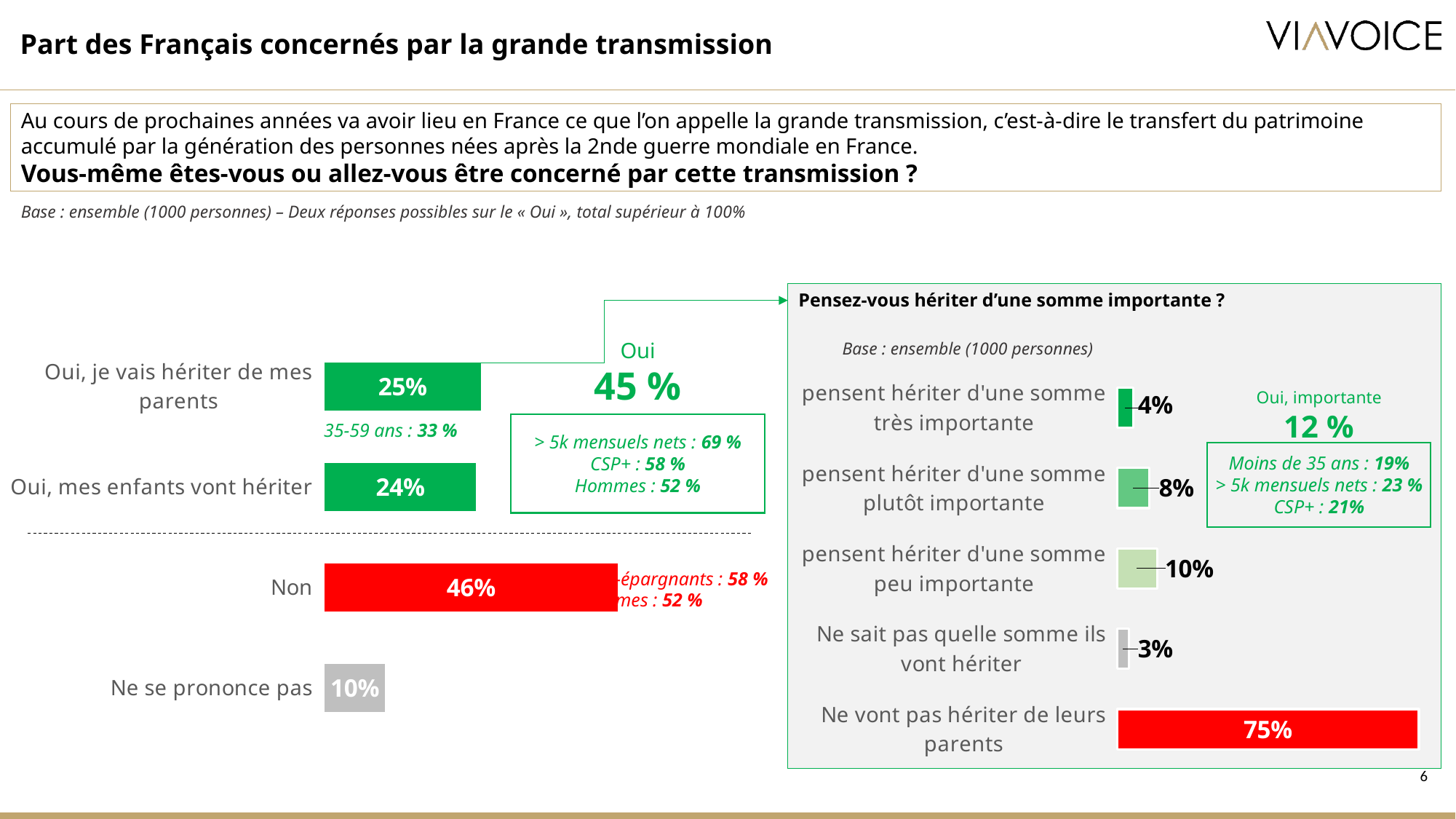
On the left chart, which category has the highest value? Non On the chart "Pensez-vous hériter d'une somme importante ?", which category has the lowest value? Ne sait pas quelle somme ils vont hériter On the chart "Pensez-vous hériter d'une somme importante ?", what is the value for "Ne vont pas hériter de leurs parents"? 75% On the left chart, what is the value for "Non"? 46% On the chart "Pensez-vous hériter d'une somme importante ?", what is the value for "pensent hériter d'une somme plutôt importante"? 8% What kind of chart is the chart "Pensez-vous hériter d'une somme importante ?"? Bar chart On the chart "Pensez-vous hériter d'une somme importante ?", which is larger: "pensent hériter d'une somme très importante" or "pensent hériter d'une somme peu importante"? pensent hériter d'une somme peu importante On the left chart, which category has the lowest value? Ne se prononce pas On the chart "Pensez-vous hériter d'une somme importante ?", how many categories are shown? 5 On the left chart, how many categories are shown? 4 On the left chart, what is the difference between "Non" and "Oui, mes enfants vont héritier"? 22 percentage points On the left chart, what is the value for "Oui, je vais hériter de mes parents"? 25%